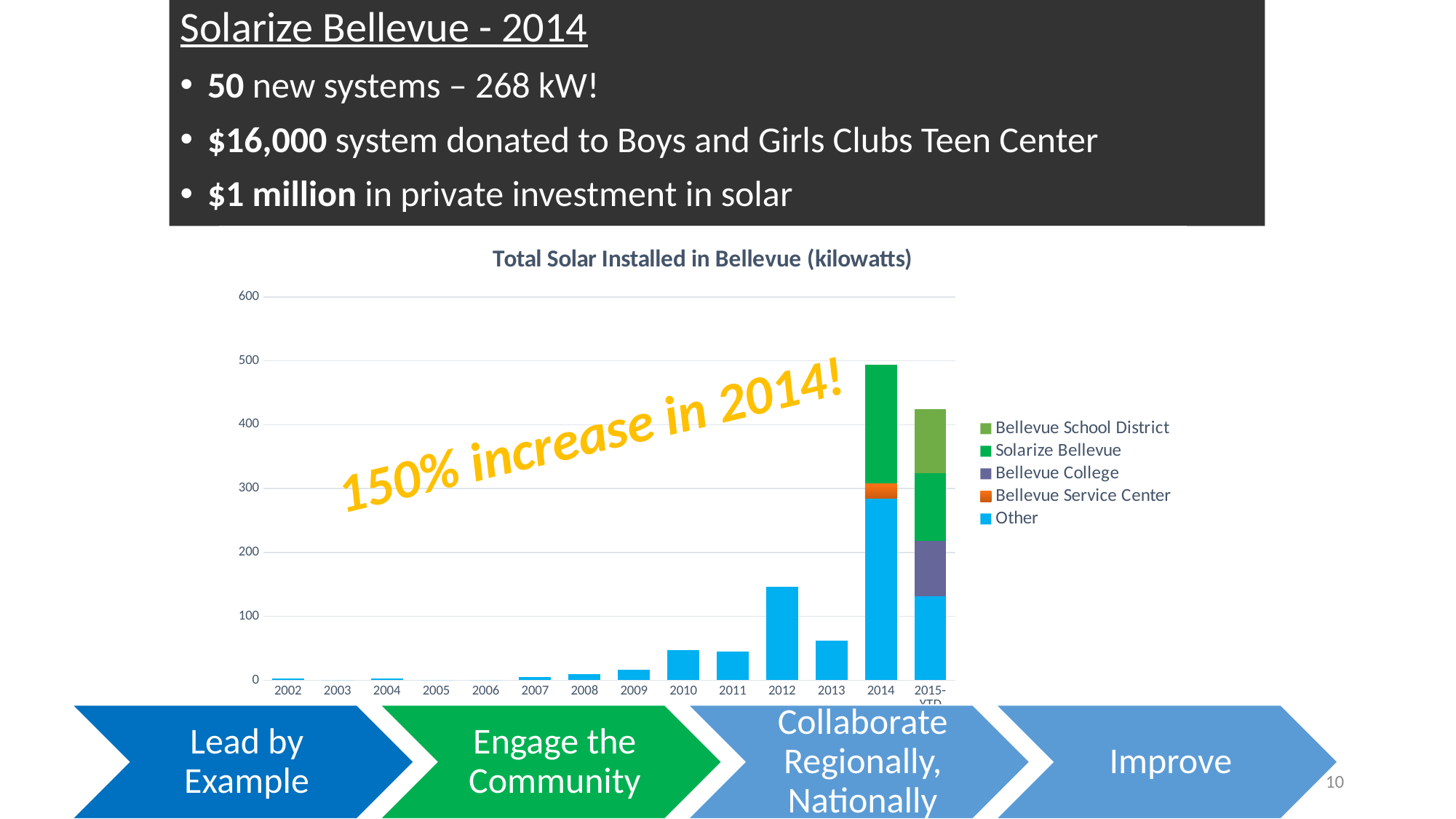
How many series does the chart legend list? 5 Is the value for 2013 greater or less than 100? less How many year categories are shown on the x axis? 14 Is the value for 2012 greater or less than 100? greater Which is larger, the value for 2012 or the value for 2013? 2012 What is the title of the chart? Total Solar Installed in Bellevue (kilowatts) Is the total value for 2015-YTD greater or less than 300? greater Do the bar values generally rise or fall from 2002 to 2014? rise What kind of chart is shown on the slide? Stacked bar chart Which is larger, the total for 2014 or the total for 2015-YTD? 2014 Which year has the tallest bar? 2014